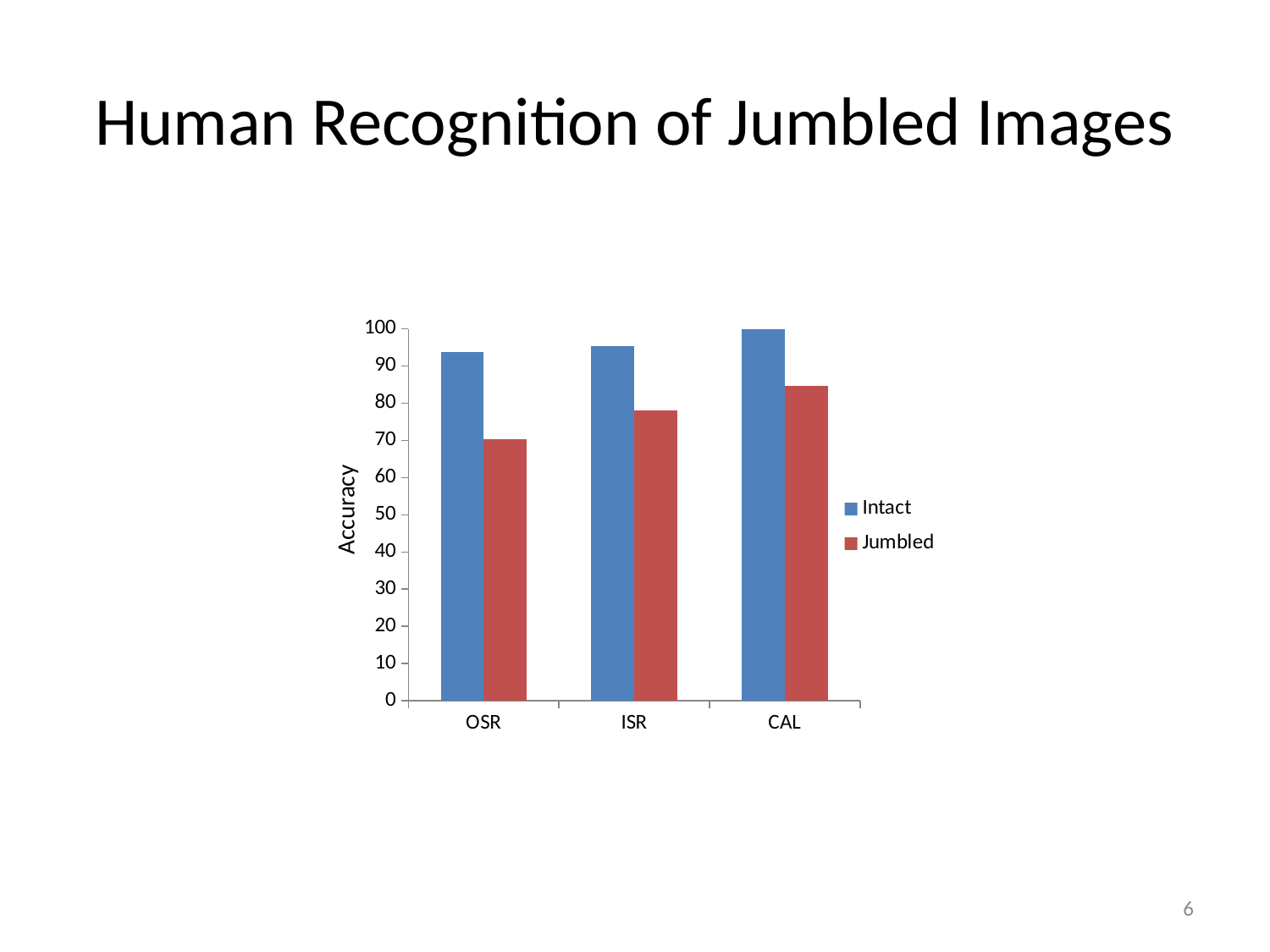
Do the Jumbled values rise or fall going from OSR to ISR to CAL? rise Is the Intact value for OSR greater or less than 90? greater How many categories are shown on the x axis of the chart? 3 Which category has the highest Jumbled accuracy? CAL Which category has the highest Intact accuracy? CAL What kind of chart is shown on the slide? bar chart For OSR, which is larger: the Intact value or the Jumbled value? Intact Which category has the lowest Jumbled accuracy? OSR Is the Jumbled value for OSR greater or less than 80? less Is the Jumbled value for CAL greater or less than 80? greater How many series does the chart's legend list? 2 What is the label on the chart's vertical axis? Accuracy